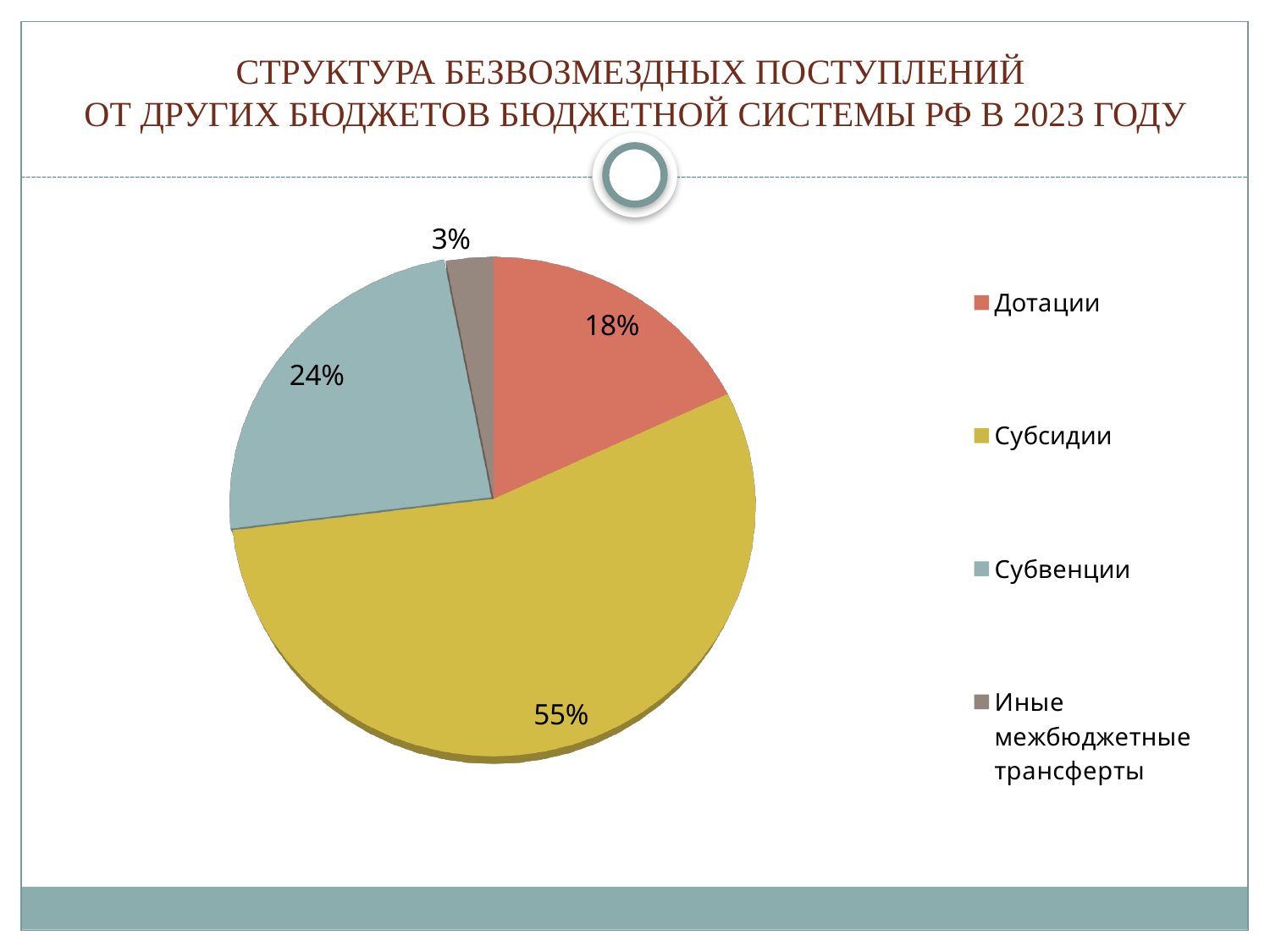
Which colour represents Субвенции in the legend? Light blue-grey What is the value shown for Дотации? 18% What is the value shown for Субвенции? 24% What is the difference between the shares of Субсидии and Субвенции? 31% What share of the pie does Субсидии represent? 55% What is the difference between the shares of Субвенции and Дотации? 6% How many categories are shown in the pie chart? 4 Which is larger, the share of Дотации or the share of Субвенции? Субвенции Which category has the smallest slice of the pie? Иные межбюджетные трансферты Which category has the largest slice of the pie? Субсидии What kind of chart is shown on the slide? Pie chart What is the value shown for Иные межбюджетные трансферты? 3%